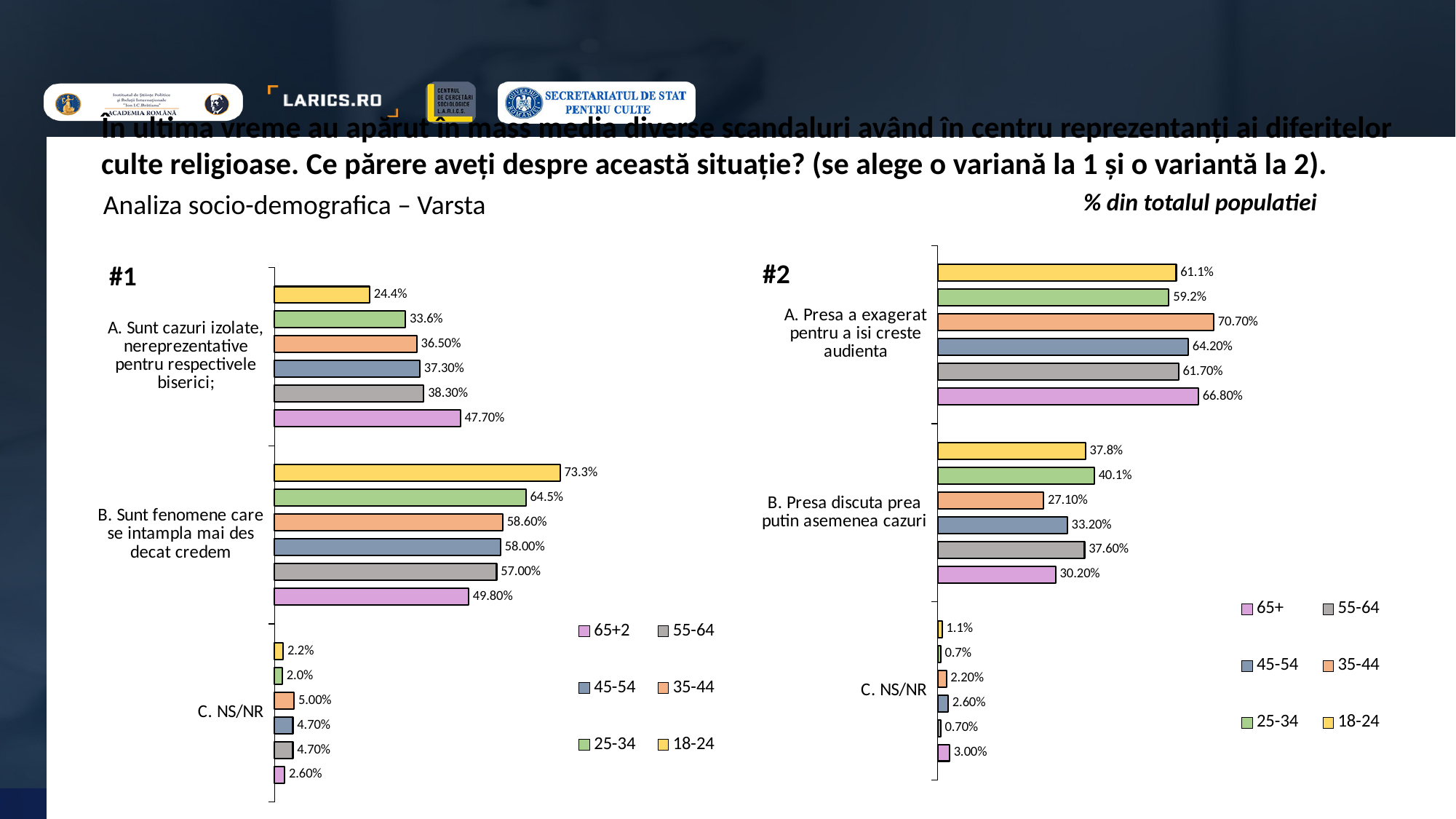
In chart #1, what is the value for the 18-24 group for 'B. Sunt fenomene care se intampla mai des decat credem'? 73.3% In chart #2, which age group has the lowest value for 'B. Presa discuta prea putin asemenea cazuri'? 35-44 How many categories are shown on the y axis of chart #1? 3 In chart #2, what is the value for the 35-44 group for 'A. Presa a exagerat pentru a isi creste audienta'? 70.70% In chart #2, what is the value for the 65+ group for 'C. NS/NR'? 3.00% How many series does the legend of chart #2 list? 6 In chart #2, which is larger for 'A. Presa a exagerat pentru a isi creste audienta': the 25-34 value or the 65+ value? 65+ In chart #1, what is the difference between the 18-24 value and the 65+ value for 'B. Sunt fenomene care se intampla mai des decat credem'? 23.5% In chart #2, what is the value for the 45-54 group for 'B. Presa discuta prea putin asemenea cazuri'? 33.20% What type of chart is chart #2? Bar chart In chart #1, which age group has the highest value for 'A. Sunt cazuri izolate, nereprezentative pentru respectivele biserici'? 65+2 In chart #1, what is the value for the 55-64 group for 'A. Sunt cazuri izolate, nereprezentative pentru respectivele biserici'? 38.30%